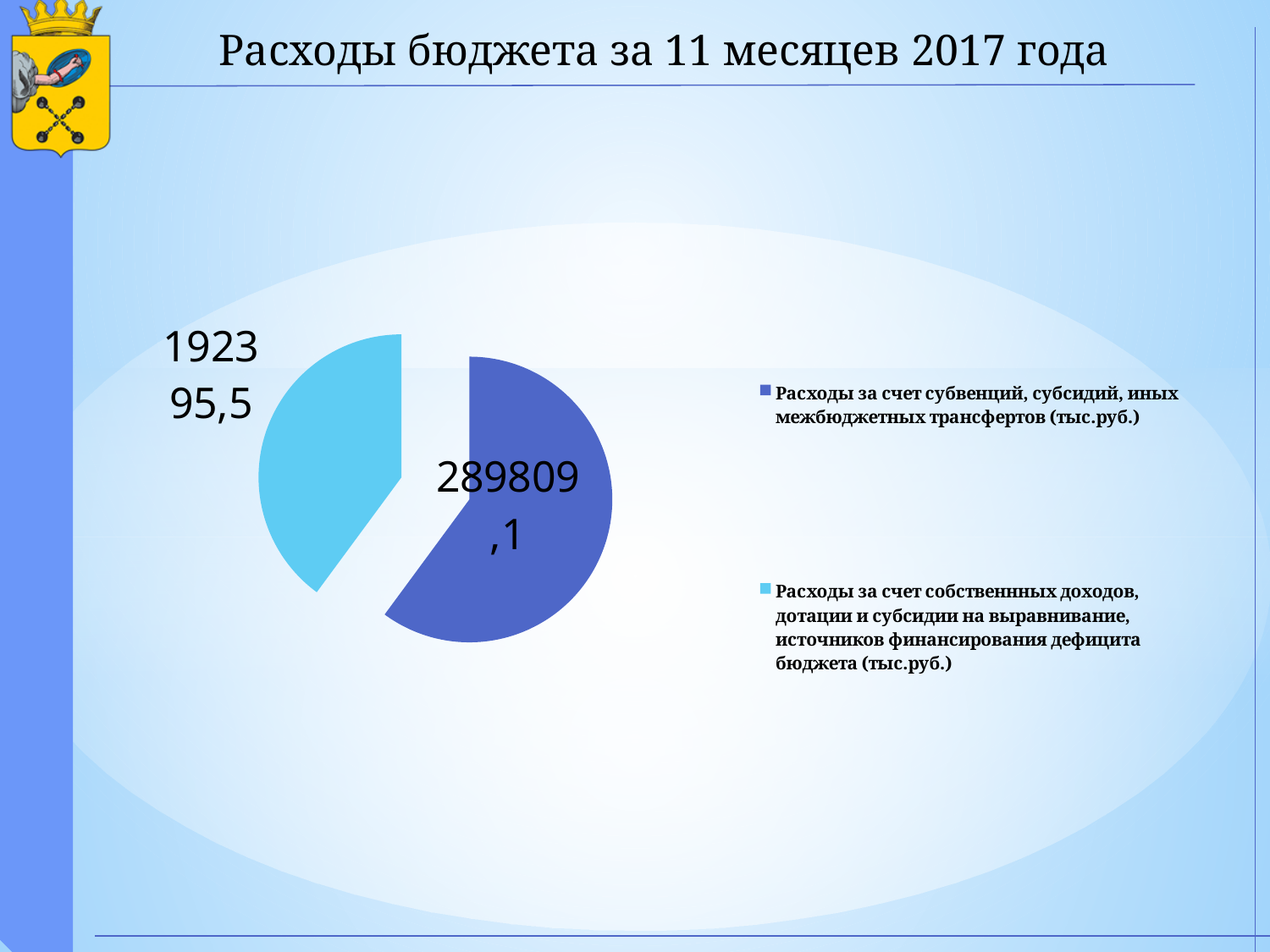
What is the title of the slide containing the chart? Расходы бюджета за 11 месяцев 2017 года What is the total of the two values shown in the pie chart? 482204,6 How many slices does the pie chart have? 2 Which category has the largest slice of the pie? Расходы за счет субвенций, субсидий, иных межбюджетных трансфертов (тыс.руб.) Which category has the smallest slice of the pie? Расходы за счет собственнных доходов, дотации и субсидии на выравнивание, источников финансирования дефицита бюджета (тыс.руб.) How many entries does the legend list? 2 Which is larger: expenses from subventions, subsidies and other inter-budget transfers, or expenses from own revenues, grants and subsidies for equalization? Расходы за счет субвенций, субсидий, иных межбюджетных трансфертов (тыс.руб.) What colour is the slice for 'Расходы за счет собственнных доходов, дотации и субсидии на выравнивание, источников финансирования дефицита бюджета (тыс.руб.)'? light blue What kind of chart is shown on the slide? pie chart What is the difference between the value for expenses from subventions, subsidies and other inter-budget transfers and the value for expenses from own revenues? 97413,6 What is the value for 'Расходы за счет субвенций, субсидий, иных межбюджетных трансфертов (тыс.руб.)'? 289809,1 What is the value for 'Расходы за счет собственнных доходов, дотации и субсидии на выравнивание, источников финансирования дефицита бюджета (тыс.руб.)'? 192395,5